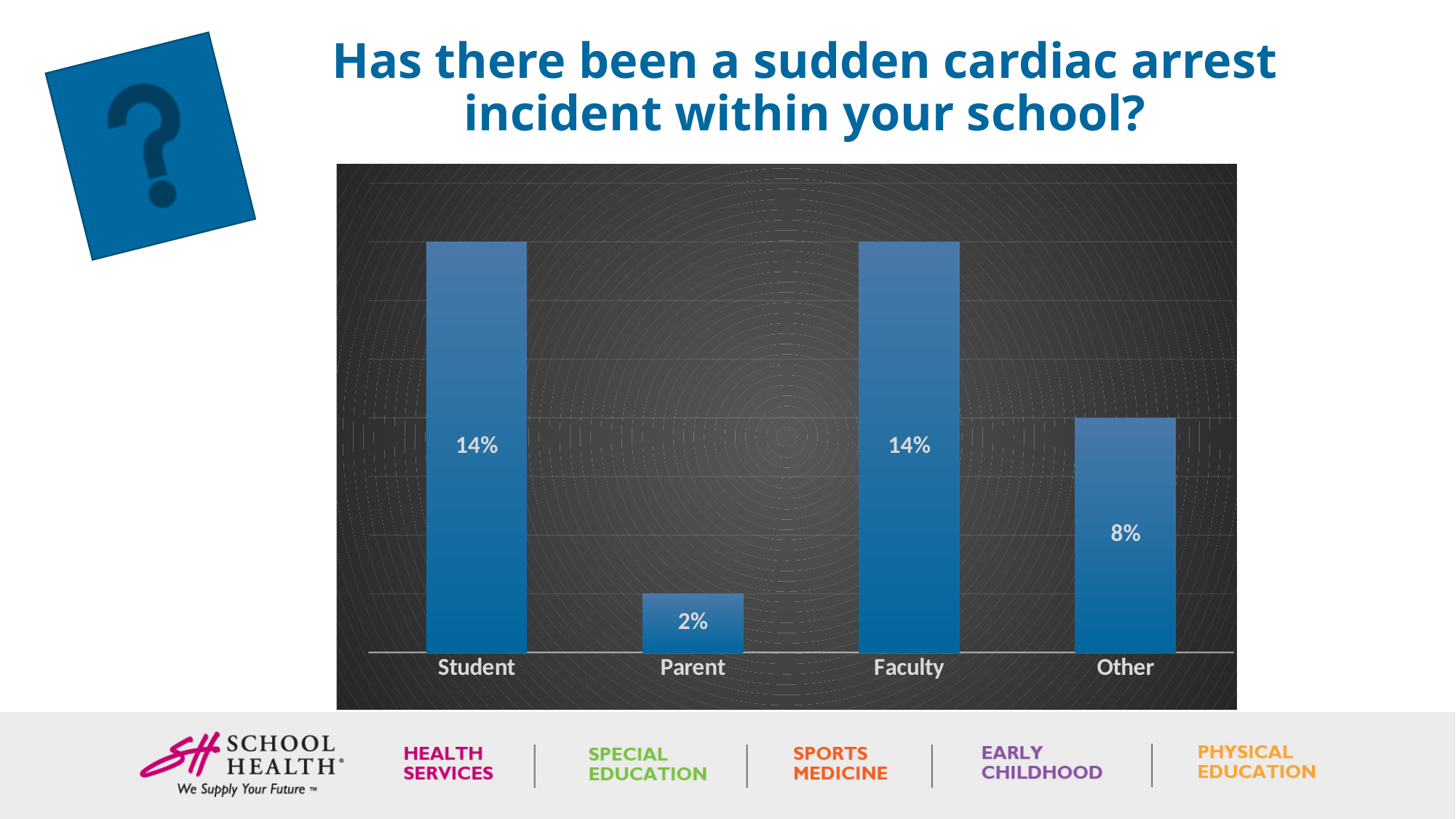
What is the difference between the values for Student and Parent? 12% What is the value for Other? 8% What is the value for Parent? 2% How many categories are shown on the chart? 4 What is the difference between the values for Faculty and Other? 6% Which is larger, the value for Other or the value for Parent? Other What is the value for Student? 14% Which is larger, the value for Student or the value for Other? Student What is the value for Faculty? 14% Which category has the lowest value? Parent What is the title of the slide above the chart? Has there been a sudden cardiac arrest incident within your school? What kind of chart is shown on the slide? Bar chart